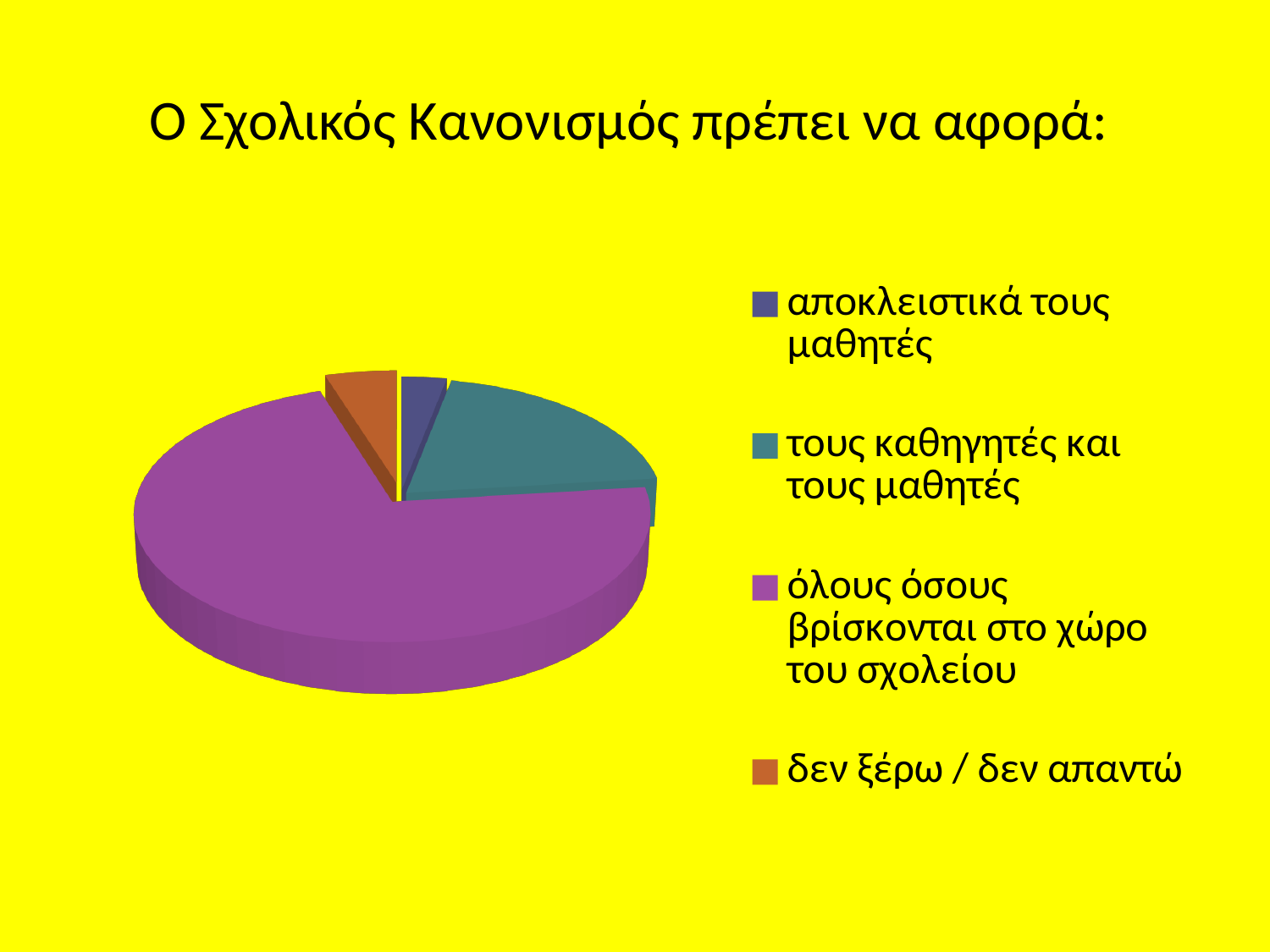
Which category has the largest slice of the pie? όλους όσους βρίσκονται στο χώρο του σχολείου How many slices does the pie chart have? 4 What is the title of the chart on the slide? Ο Σχολικός Κανονισμός πρέπει να αφορά: What colour is the slice for 'δεν ξέρω / δεν απαντώ'? orange How many entries does the legend list? 4 Which slice is larger: 'τους καθηγητές και τους μαθητές' or 'αποκλειστικά τους μαθητές'? τους καθηγητές και τους μαθητές What kind of chart is shown on the slide? pie chart Which slice is larger: 'όλους όσους βρίσκονται στο χώρο του σχολείου' or 'τους καθηγητές και τους μαθητές'? όλους όσους βρίσκονται στο χώρο του σχολείου Does the slice for 'όλους όσους βρίσκονται στο χώρο του σχολείου' cover more or less than half of the pie? more